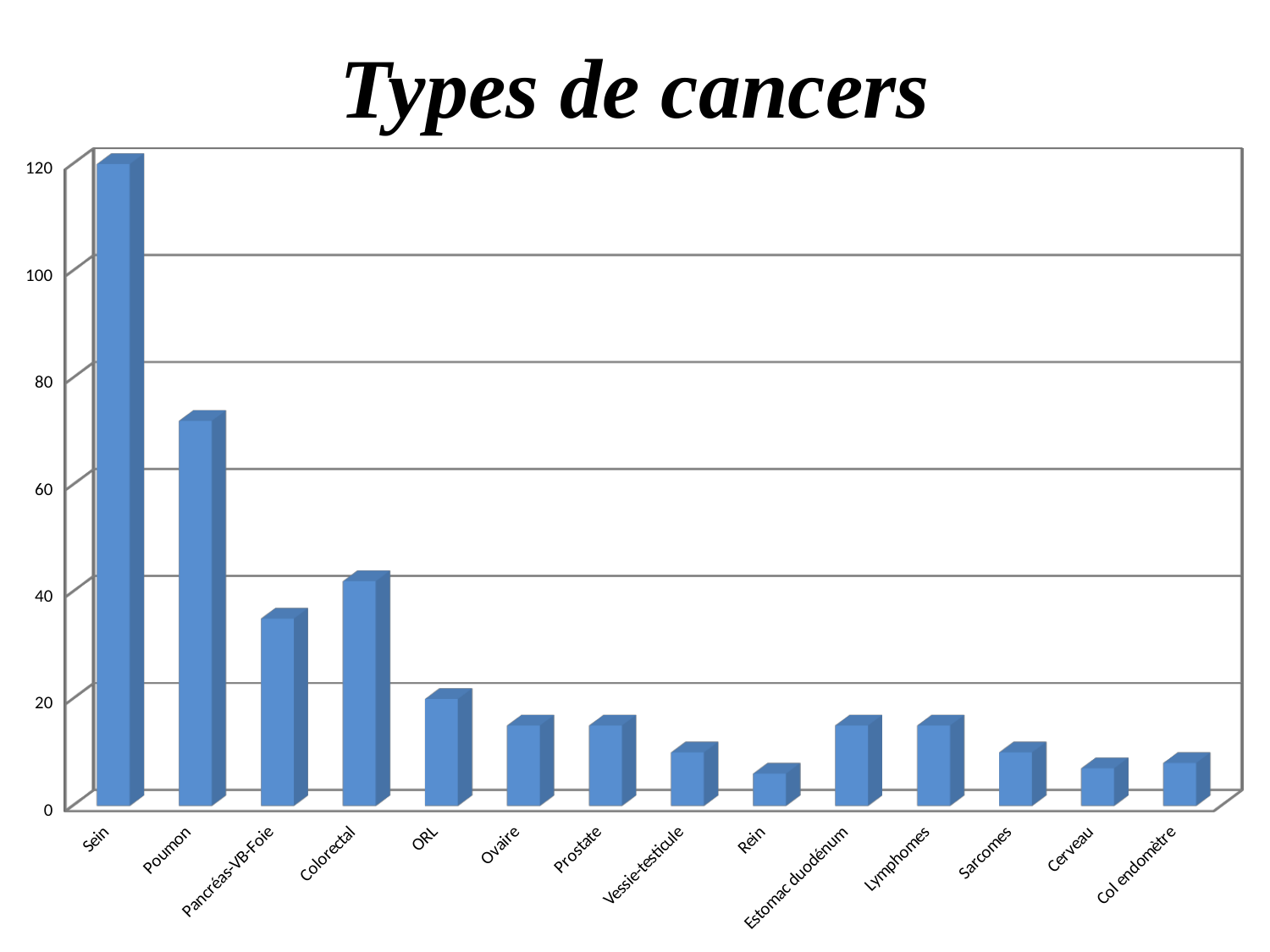
What kind of chart is shown on the slide? bar chart Is the value for Rein greater or less than 20? less How many cancer types (categories) are shown on the x axis? 14 What is the title of the chart? Types de cancers Is the value for Poumon greater or less than 60? greater Is the value for Sein greater or less than 100? greater Which cancer type has the highest bar? Sein Which is larger, the value for Colorectal or the value for Pancréas-VB-Foie? Colorectal Which is larger, the value for Poumon or the value for Colorectal? Poumon What colour are the bars in the chart? blue